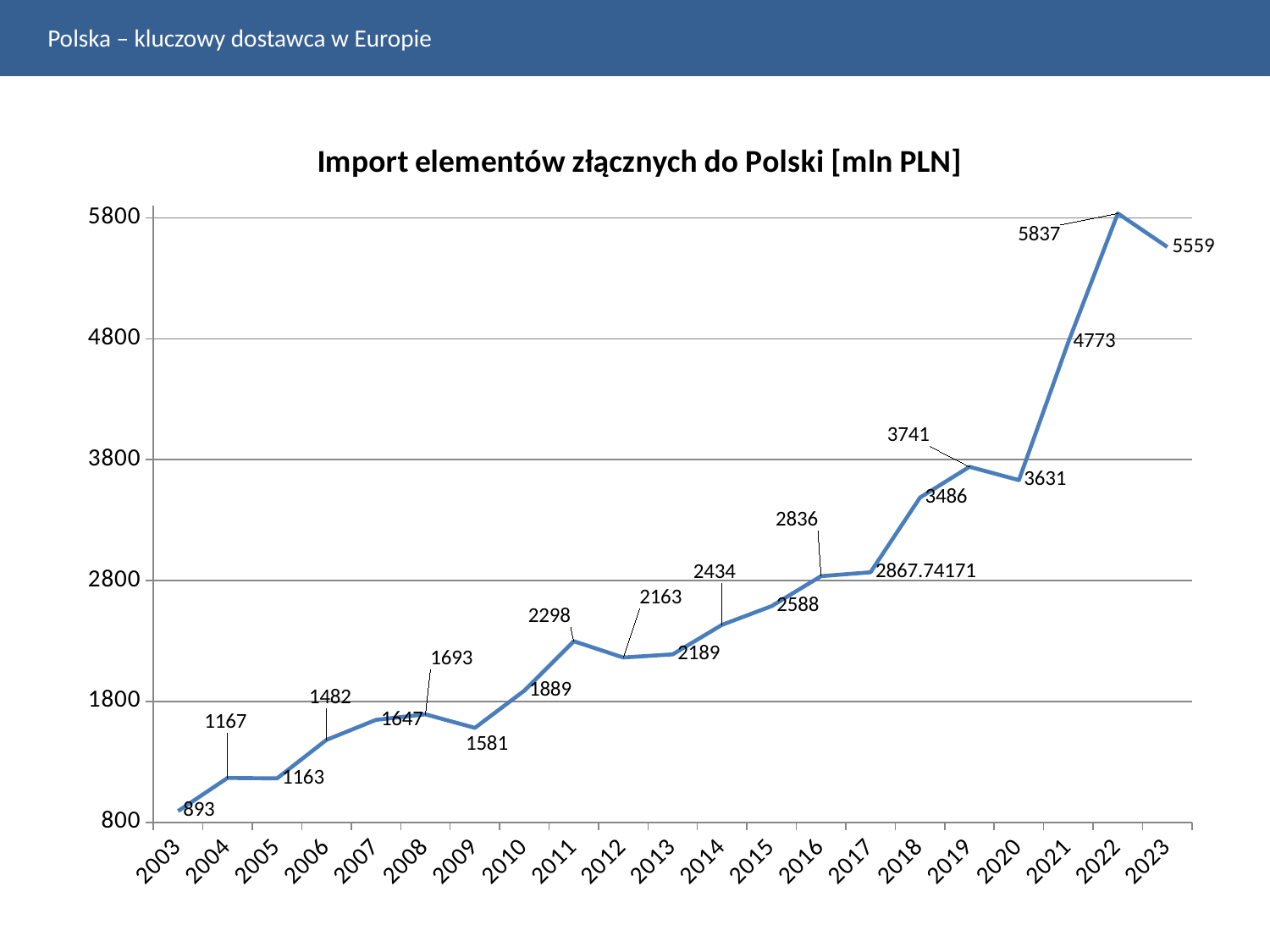
What is the title of the chart? Import elementów złącznych do Polski [mln PLN] What is the value for 2003? 893 What is the value for 2009? 1581 What is the value for 2022? 5837 What kind of chart is shown on the slide? line chart What is the value for 2020? 3631 What is the difference between the values for 2022 and 2023? 278 Which is larger, the value for 2011 or the value for 2012? 2011 Which year has the lowest value? 2003 How many years are plotted on the chart? 21 Is the value for 2021 greater or less than 4800? less Which year has the highest value? 2022